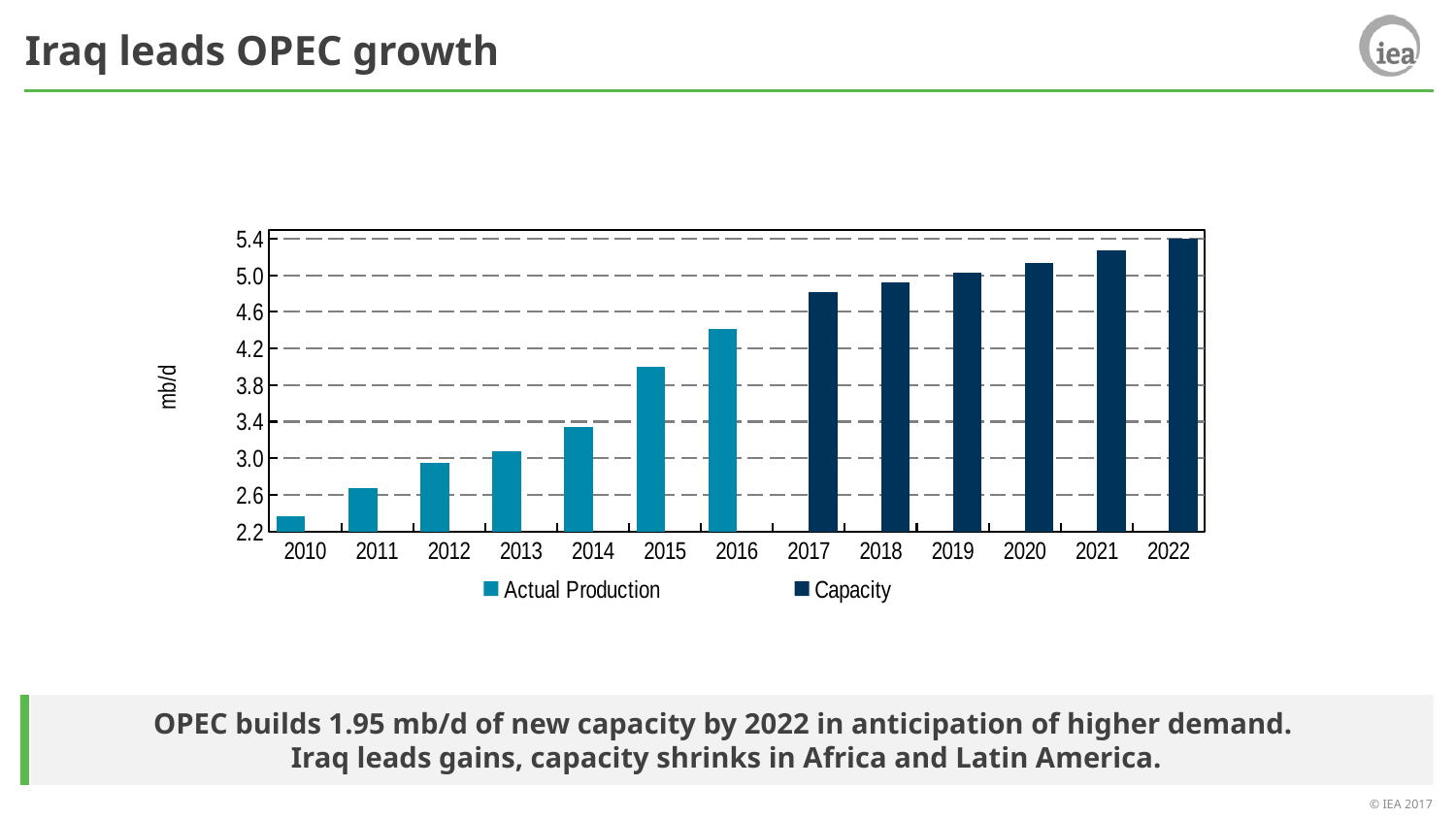
What are the two series named in the legend? Actual Production and Capacity Is the value for 2017 greater or less than 4.6? greater How many series does the legend list? 2 What kind of chart is shown on the slide? bar chart Which year has the lowest bar? 2010 Is the value for 2016 greater or less than 4.2? greater Which year has the highest bar? 2022 Do the values rise or fall from 2010 to 2022? rise How many years are shown on the x axis? 13 What unit is shown on the y axis? mb/d Which is larger, the value for 2016 or the value for 2013? 2016 Is the value for 2010 greater or less than 2.6? less